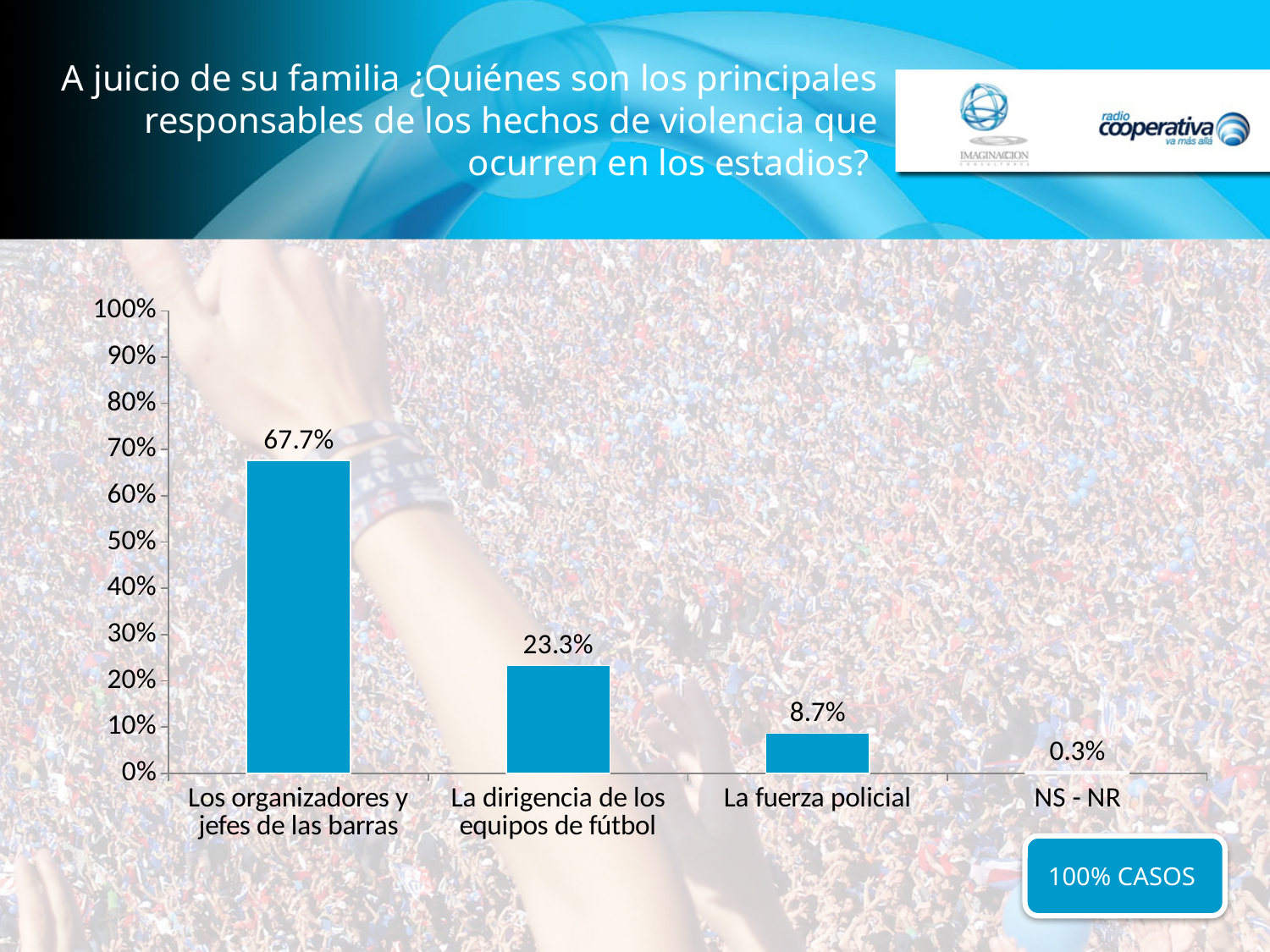
Which category has the highest value? Los organizadores y jefes de las barras How many categories are shown on the x axis? 4 Is the value for "Los organizadores y jefes de las barras" greater or less than 60%? greater What is the value for "La fuerza policial"? 8.7% What is the difference between the values for "Los organizadores y jefes de las barras" and "La dirigencia de los equipos de fútbol"? 44.4% What is the value for "Los organizadores y jefes de las barras"? 67.7% What kind of chart is shown on the slide? bar chart Which is larger, the value for "La dirigencia de los equipos de fútbol" or the value for "La fuerza policial"? La dirigencia de los equipos de fútbol What is the value for "NS - NR"? 0.3% Which category has the lowest value? NS - NR Do the values rise or fall from left to right along the x axis? fall What is the value for "La dirigencia de los equipos de fútbol"? 23.3%